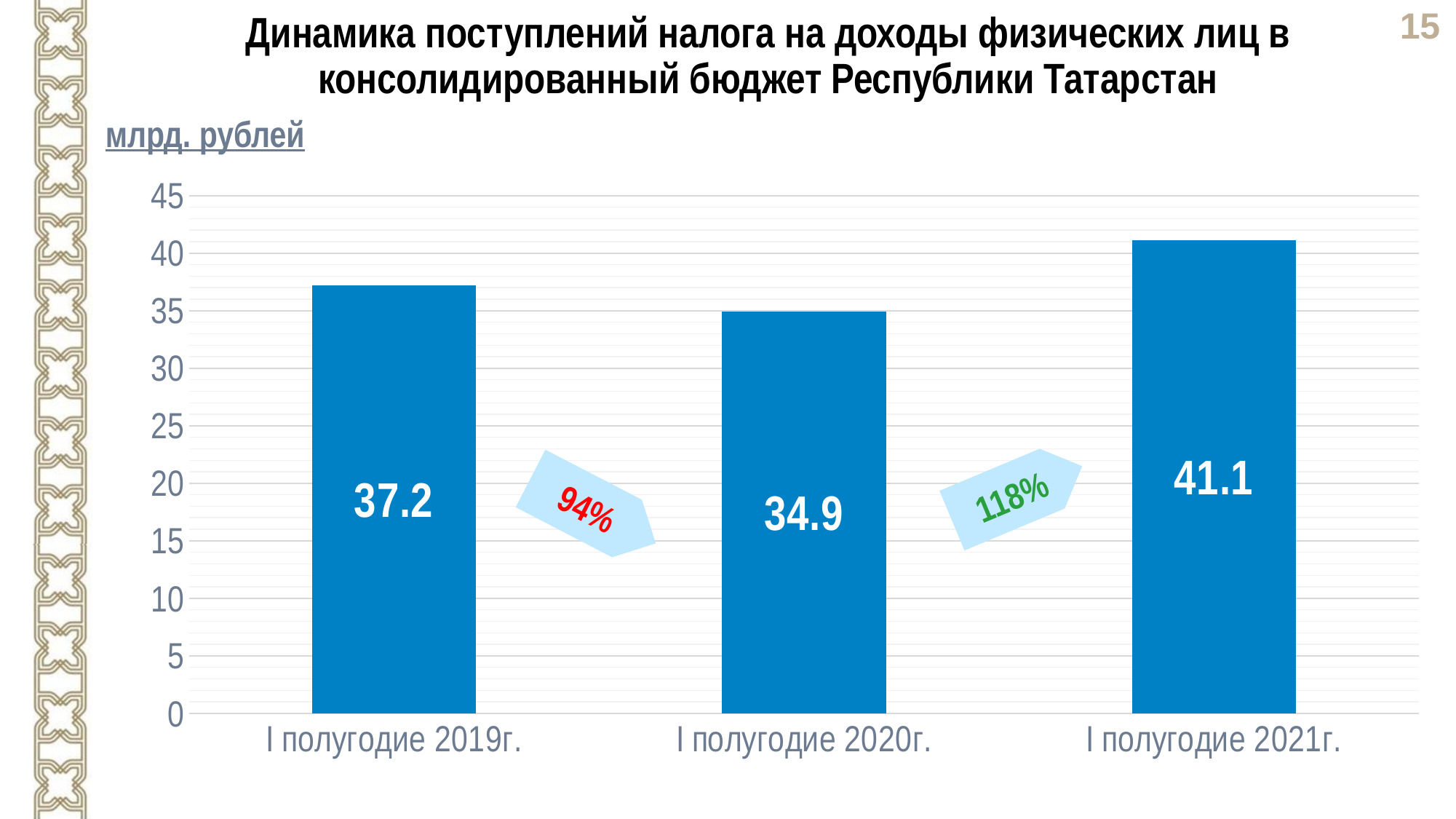
What is the difference between the values for I полугодие 2019г. and I полугодие 2020г.? 2.3 What is the value for I полугодие 2019г.? 37.2 What is the value for I полугодие 2021г.? 41.1 What kind of chart is shown on the slide? bar chart How many periods are shown on the chart? 3 Is the value for I полугодие 2021г. greater or less than 40? greater Which period has the lowest value? I полугодие 2020г. What is the value for I полугодие 2020г.? 34.9 Which is larger, the value for I полугодие 2019г. or I полугодие 2021г.? I полугодие 2021г. What unit of measurement is indicated for the chart? млрд. рублей Which period has the highest value? I полугодие 2021г. What is the difference between the values for I полугодие 2021г. and I полугодие 2020г.? 6.2